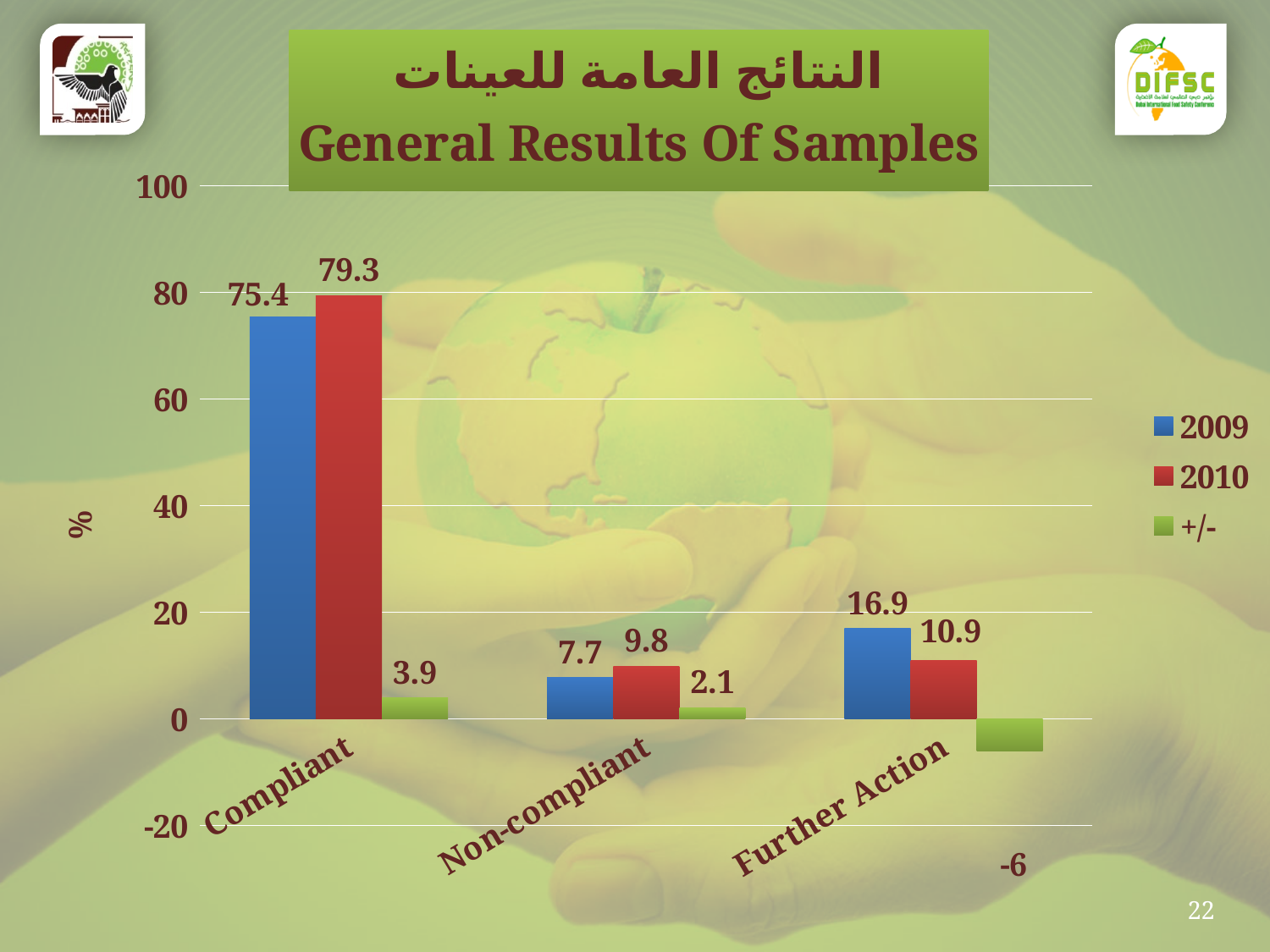
What is the +/- value for Further Action? -6 What is the difference between the 2010 and 2009 values for Compliant? 3.9 Which category has the lowest 2010 value? Non-compliant How many series does the legend list? 3 What is the 2010 value for Compliant? 79.3 Which is larger for Further Action: the 2009 value or the 2010 value? 2009 How many categories are shown on the x axis? 3 What is the label on the vertical axis? % What is the +/- value for Non-compliant? 2.1 Which category has the highest 2009 value? Compliant What kind of chart is shown on the slide? Bar chart What is the 2009 value for Further Action? 16.9